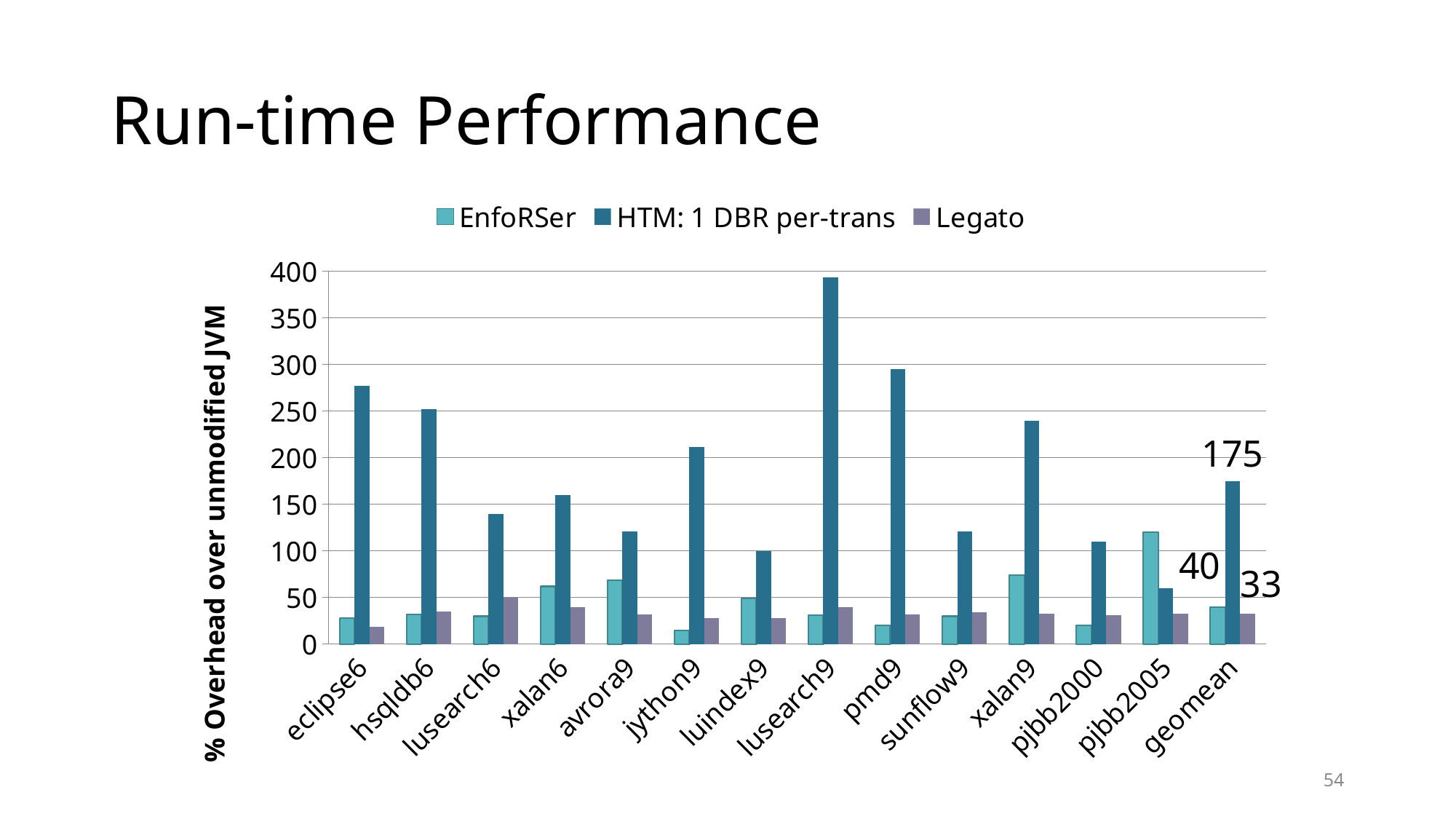
How many series does the legend list? 3 What is the value for Legato at geomean? 33 Is the HTM: 1 DBR per-trans value for eclipse6 greater or less than 250? greater What is the value for HTM: 1 DBR per-trans at geomean? 175 At geomean, what is the difference between the HTM: 1 DBR per-trans value and the Legato value? 142 Which benchmark has the highest EnfoRSer bar? pjbb2005 What is the value for EnfoRSer at geomean? 40 Which benchmark has the highest HTM: 1 DBR per-trans bar? lusearch9 What kind of chart is shown on the slide? bar chart Is the HTM: 1 DBR per-trans value for pjbb2005 greater or less than 100? less What is the label of the y axis? % Overhead over unmodified JVM How many benchmark categories are shown on the x axis? 14